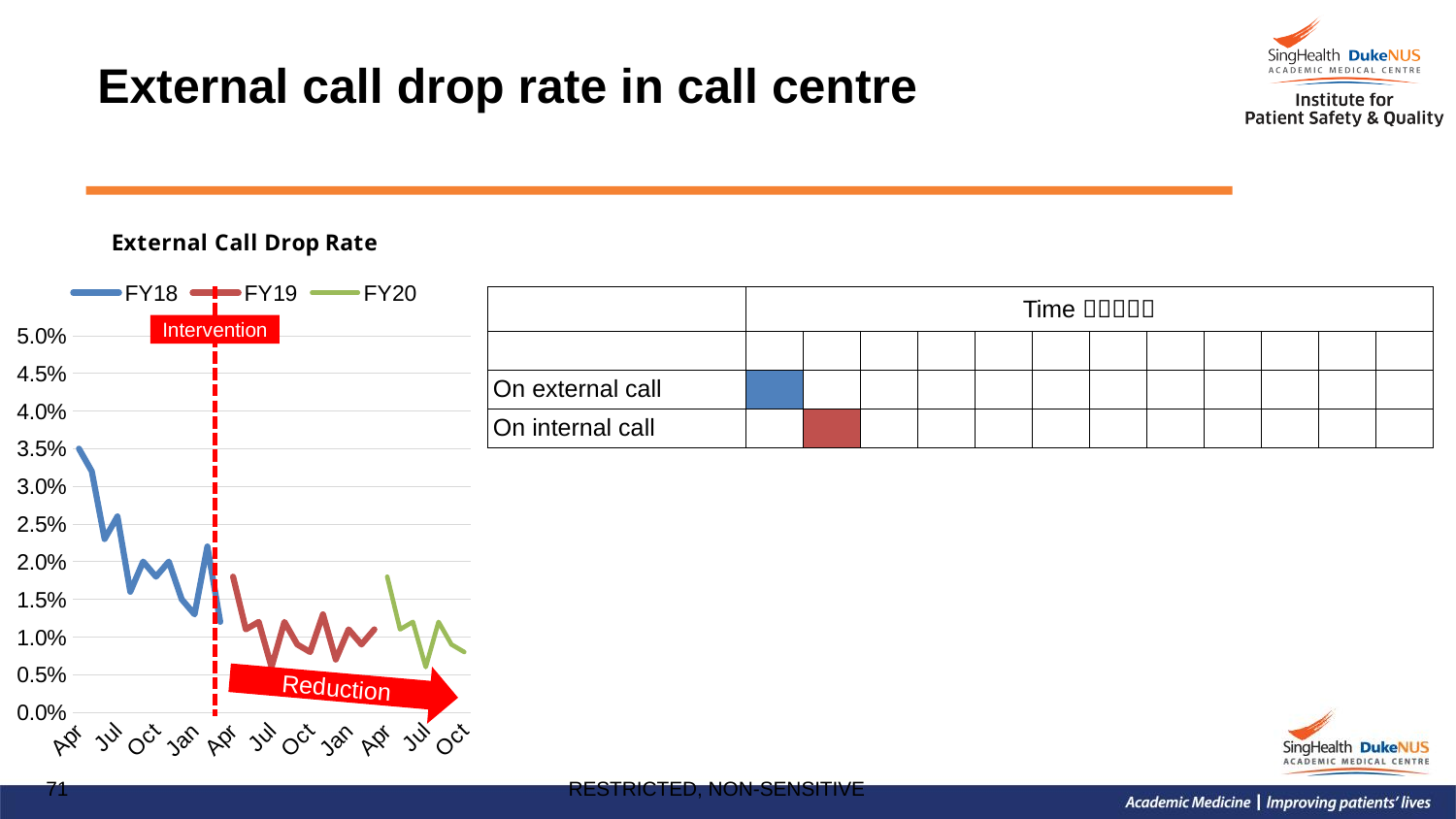
In the External Call Drop Rate chart, is the FY19 value for Apr greater or less than 2.5%? less How many series does the legend of the External Call Drop Rate chart list? 3 What kind of chart is shown under the title "External Call Drop Rate"? line chart In the External Call Drop Rate chart, is the FY18 value for Apr greater or less than 3.0%? greater What are the series names in the legend of the External Call Drop Rate chart? FY18, FY19, FY20 Which series reaches the highest value in the External Call Drop Rate chart? FY18 In the External Call Drop Rate chart, is the FY20 value for Oct greater or less than 1.5%? less Overall, does the external call drop rate rise or fall across FY18 to FY20 in the chart? fall In the External Call Drop Rate chart, which is larger: the FY18 value for Apr or the FY20 value for Apr? FY18 value for Apr What is the highest value shown on the y axis of the External Call Drop Rate chart? 5.0% Does the FY18 line in the External Call Drop Rate chart generally rise or fall from Apr to Jan? fall What colour is the FY19 line in the External Call Drop Rate chart? red